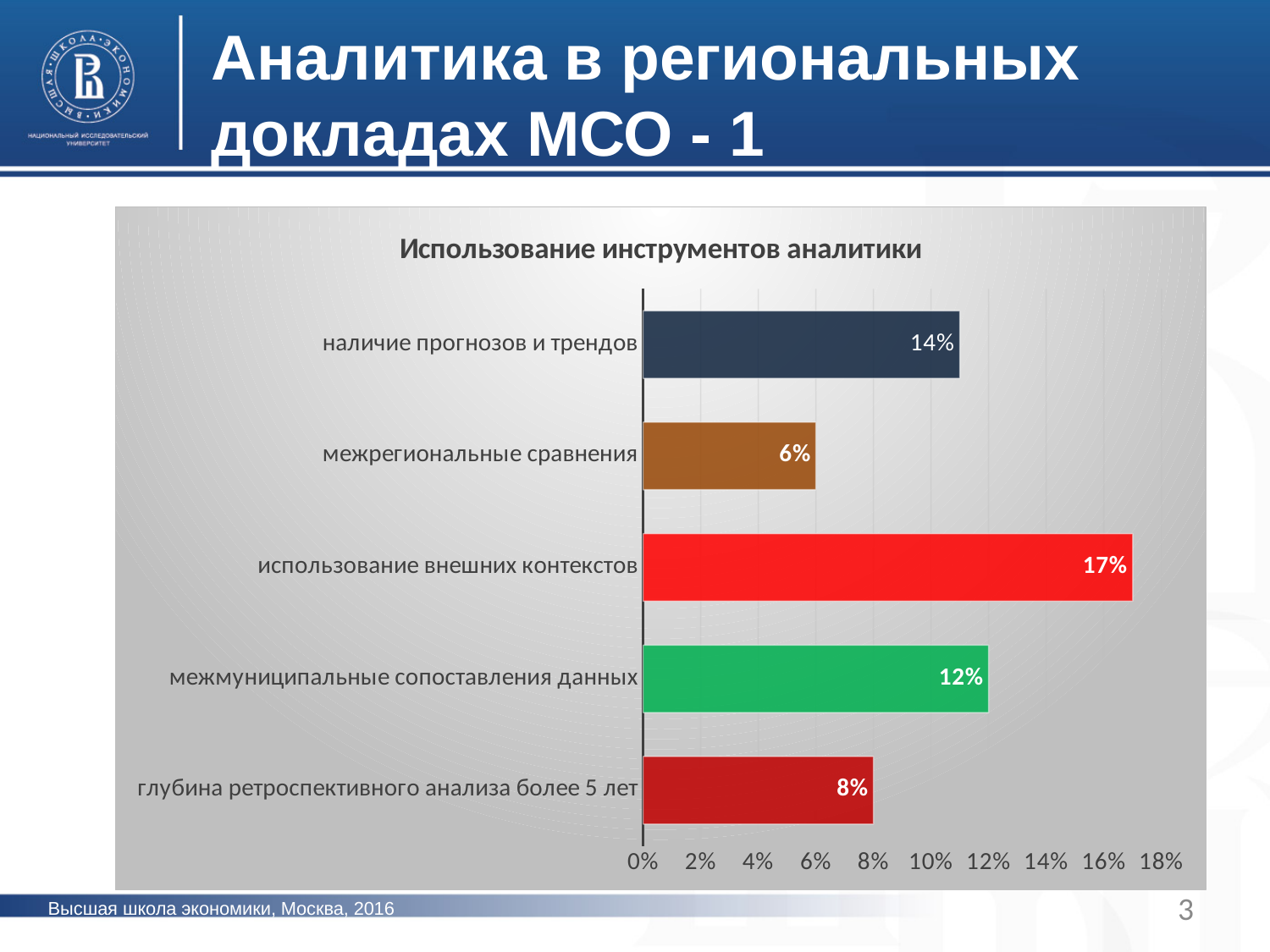
What is the value for «глубина ретроспективного анализа более 5 лет»? 8% What is the title of the chart? Использование инструментов аналитики What kind of chart is shown on the slide? bar chart Is the value for «межмуниципальные сопоставления данных» greater or less than 10%? greater What is the difference between «использование внешних контекстов» and «межмуниципальные сопоставления данных»? 5% Which category has the highest value? использование внешних контекстов What is the value for «межрегиональные сравнения»? 6% How many categories are shown in the chart? 5 What colour is the bar for «использование внешних контекстов»? red Which category has the lowest value? межрегиональные сравнения What is the value for «наличие прогнозов и трендов»? 14%